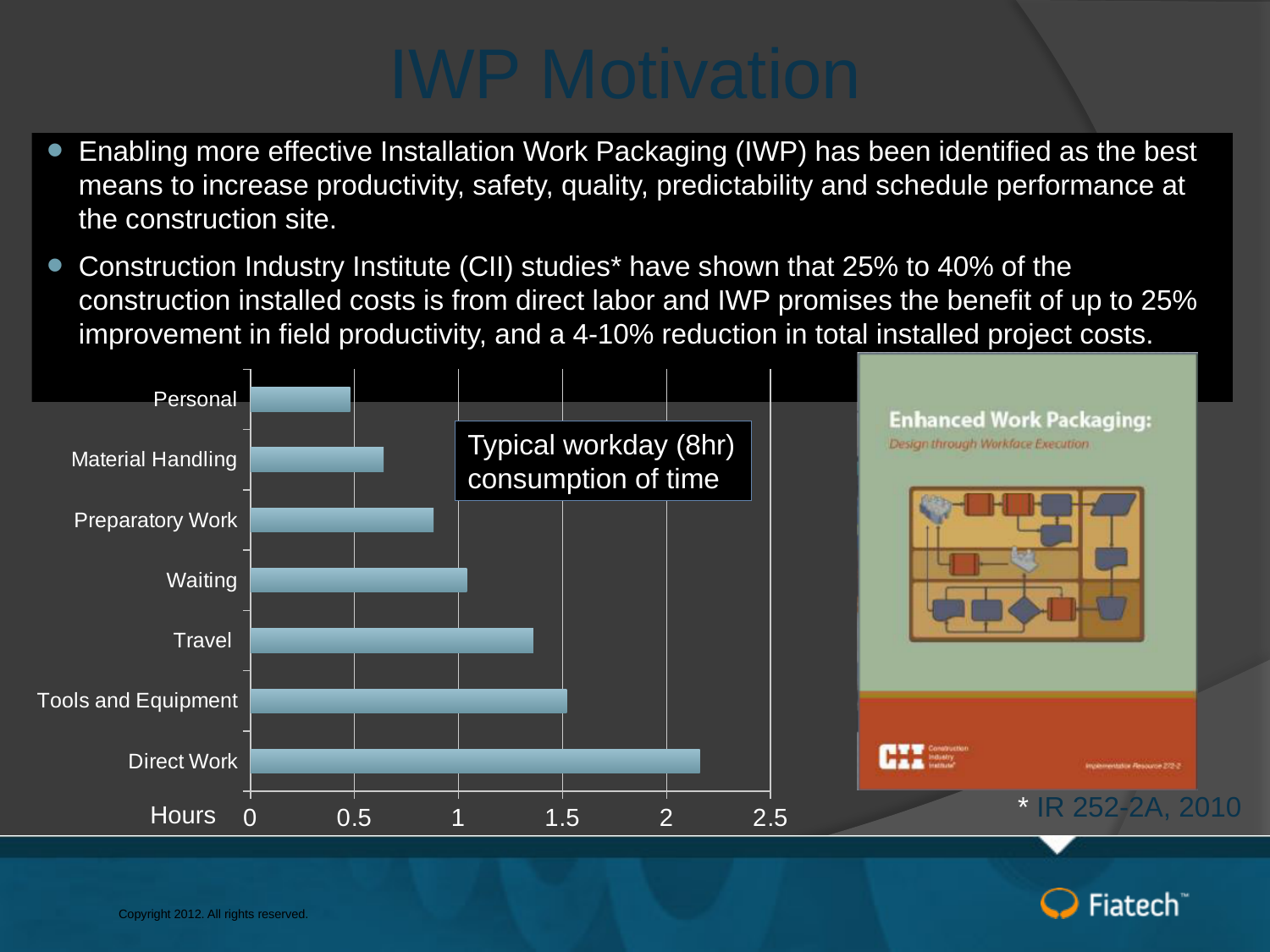
How many categories are plotted in the bar chart? 7 Which category has the lowest value in the bar chart? Personal What does the text box on the chart say the chart shows? Typical workday (8hr) consumption of time Is the value for Travel greater or less than 1? greater What kind of chart is shown on the slide? bar chart Which is larger, the value for Travel or the value for Waiting? Travel What unit is labelled on the horizontal axis of the bar chart? Hours Is the value for Material Handling greater or less than 0.5? greater Is the value for Preparatory Work greater or less than 1? less Which category has the highest value in the bar chart? Direct Work